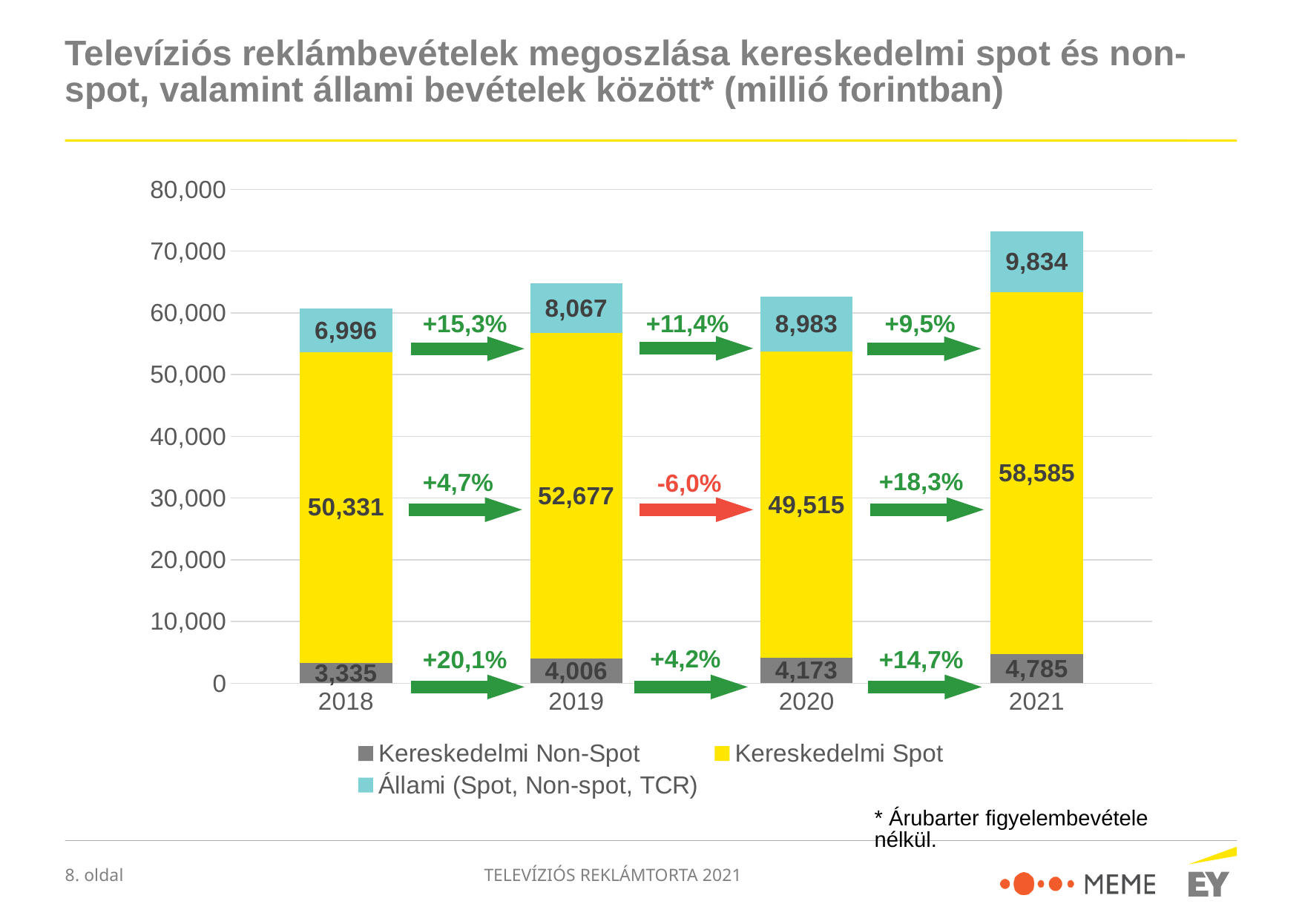
In which year is the Kereskedelmi Non-Spot value lowest? 2018 What kind of chart is shown on the slide? Stacked bar chart How many series does the legend list? 3 In which year is the Kereskedelmi Spot value highest? 2021 What is the difference between the Kereskedelmi Spot values for 2021 and 2020? 9,070 What is the Kereskedelmi Spot value for 2020? 49,515 What is the total of the stacked bar for 2018? 60,662 What is the total of the stacked bar for 2021? 73,204 What is the Kereskedelmi Non-Spot value for 2018? 3,335 Which is larger, the Állami value for 2019 or for 2020? 2020 What is the Állami (Spot, Non-spot, TCR) value for 2021? 9,834 How many years are shown on the x axis? 4